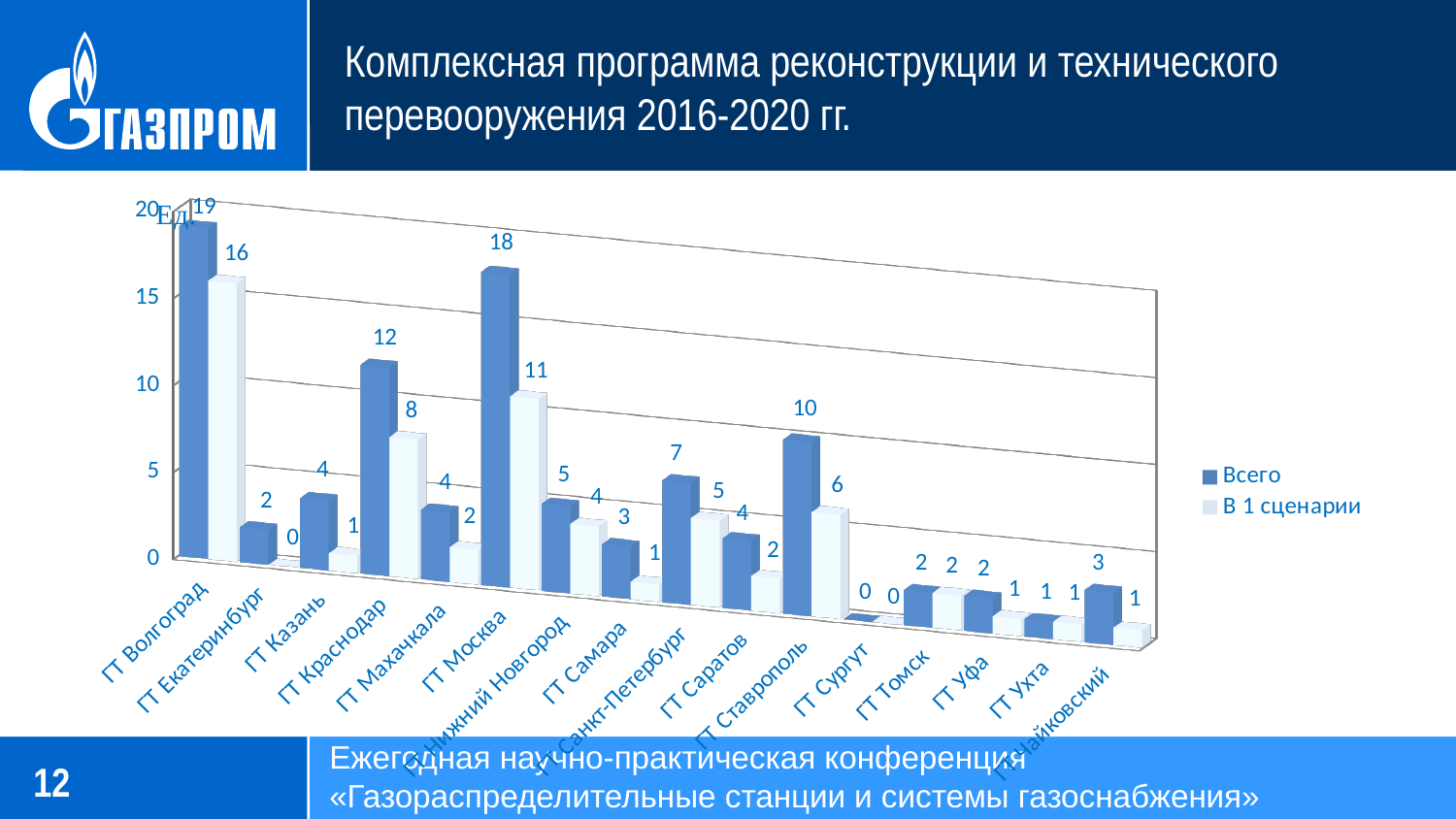
What is the value of "В 1 сценарии" for ГТ Москва? 11 What is the value of "Всего" for ГТ Волгоград? 19 How many series does the legend list? 2 Which is larger: the "Всего" value for ГТ Краснодар or for ГТ Санкт-Петербург? ГТ Краснодар What is the value of "Всего" for ГТ Ставрополь? 10 What is the value of "В 1 сценарии" for ГТ Краснодар? 8 What are the two series names listed in the legend? Всего, В 1 сценарии Which category has the lowest "Всего" value? ГТ Сургут Which category has the highest "Всего" value? ГТ Волгоград What is the difference between the "Всего" and "В 1 сценарии" values for ГТ Москва? 7 How many categories are shown on the x axis? 16 What kind of chart is shown on the slide? Bar chart